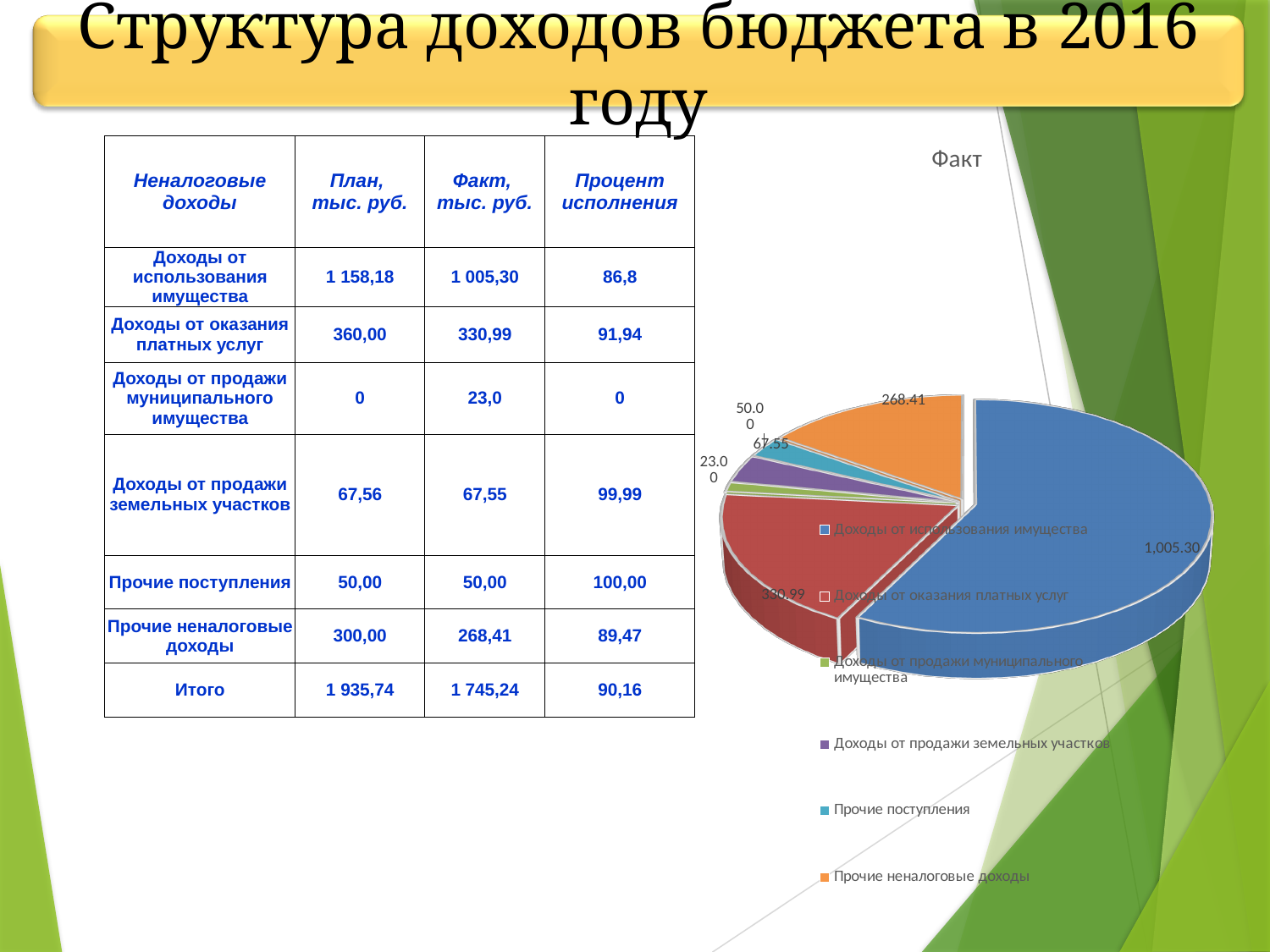
What is the value shown for Доходы от продажи земельных участков in the pie chart? 67.55 What is the value shown for Доходы от оказания платных услуг in the pie chart? 330.99 What is the difference between the values for Доходы от оказания платных услуг and Прочие неналоговые доходы in the pie chart? 62.58 What is the title of the chart on the slide? Факт What is the value shown for Доходы от использования имущества in the pie chart? 1,005.30 Which category has the largest slice in the pie chart? Доходы от использования имущества What colour is the slice for Доходы от использования имущества in the pie chart? blue How many slices does the pie chart have? 6 What is the value shown for Прочие неналоговые доходы in the pie chart? 268.41 What kind of chart is shown on the slide? pie chart Which category has the smallest slice in the pie chart? Доходы от продажи муниципального имущества Which is larger in the pie chart: Доходы от оказания платных услуг or Прочие неналоговые доходы? Доходы от оказания платных услуг